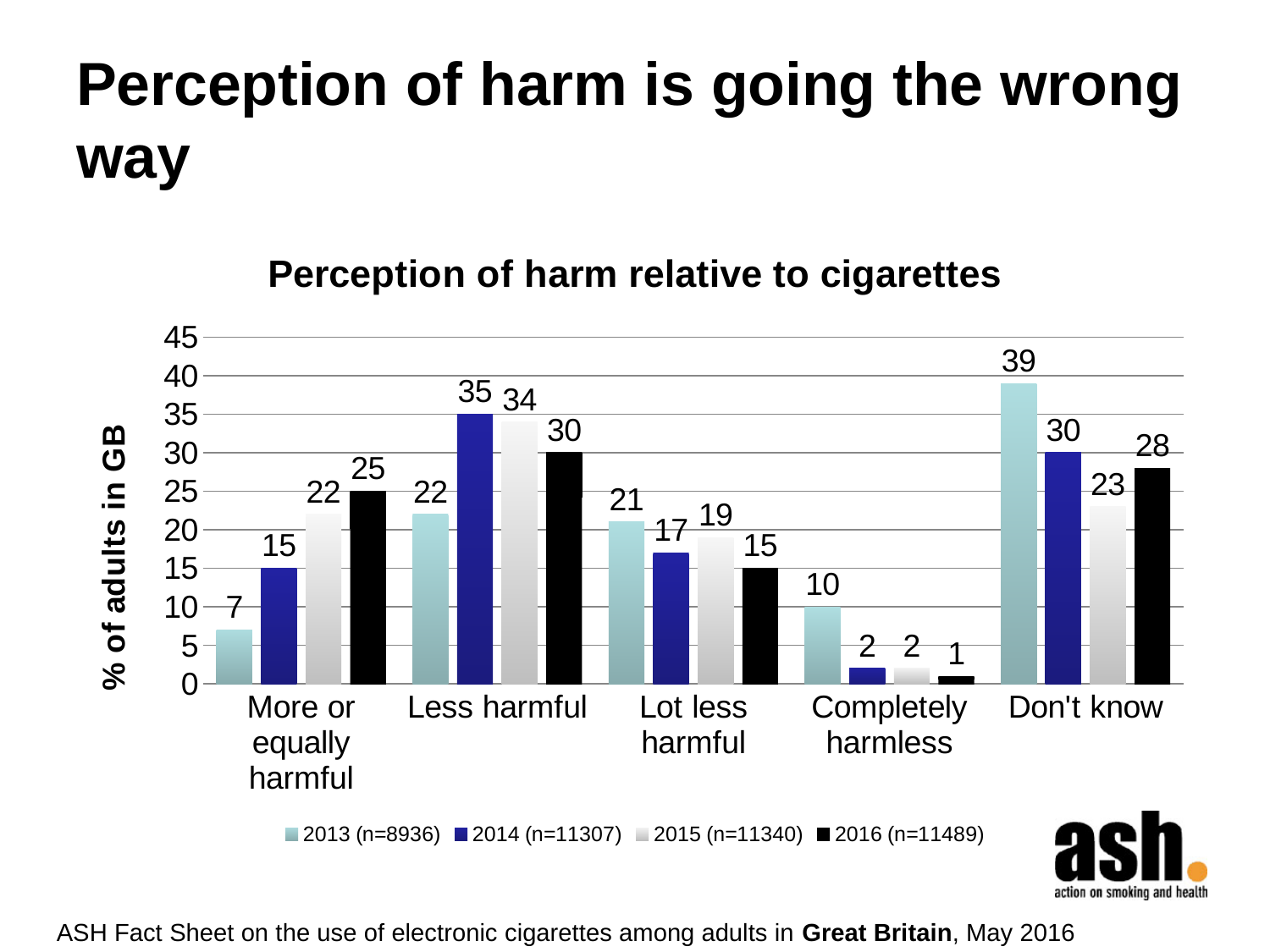
What is the value for 2013 in the 'Don't know' category? 39 What kind of chart is shown on the slide? Bar chart Do the values in the 'Completely harmless' category rise or fall from 2013 to 2016? Fall What is the title of the chart? Perception of harm relative to cigarettes What is the value for 2016 in the 'More or equally harmful' category? 25 What is the value for 2015 in the 'Less harmful' category? 34 Which category has the highest value for the 2014 series? Less harmful What is the difference between the 2013 and 2016 values in the 'More or equally harmful' category? 18 Which category has the lowest value for the 2016 series? Completely harmless Which is larger: the 2013 value for 'Lot less harmful' or the 2016 value for 'Lot less harmful'? 2013 How many series does the legend list? 4 How many categories are shown on the x axis? 5